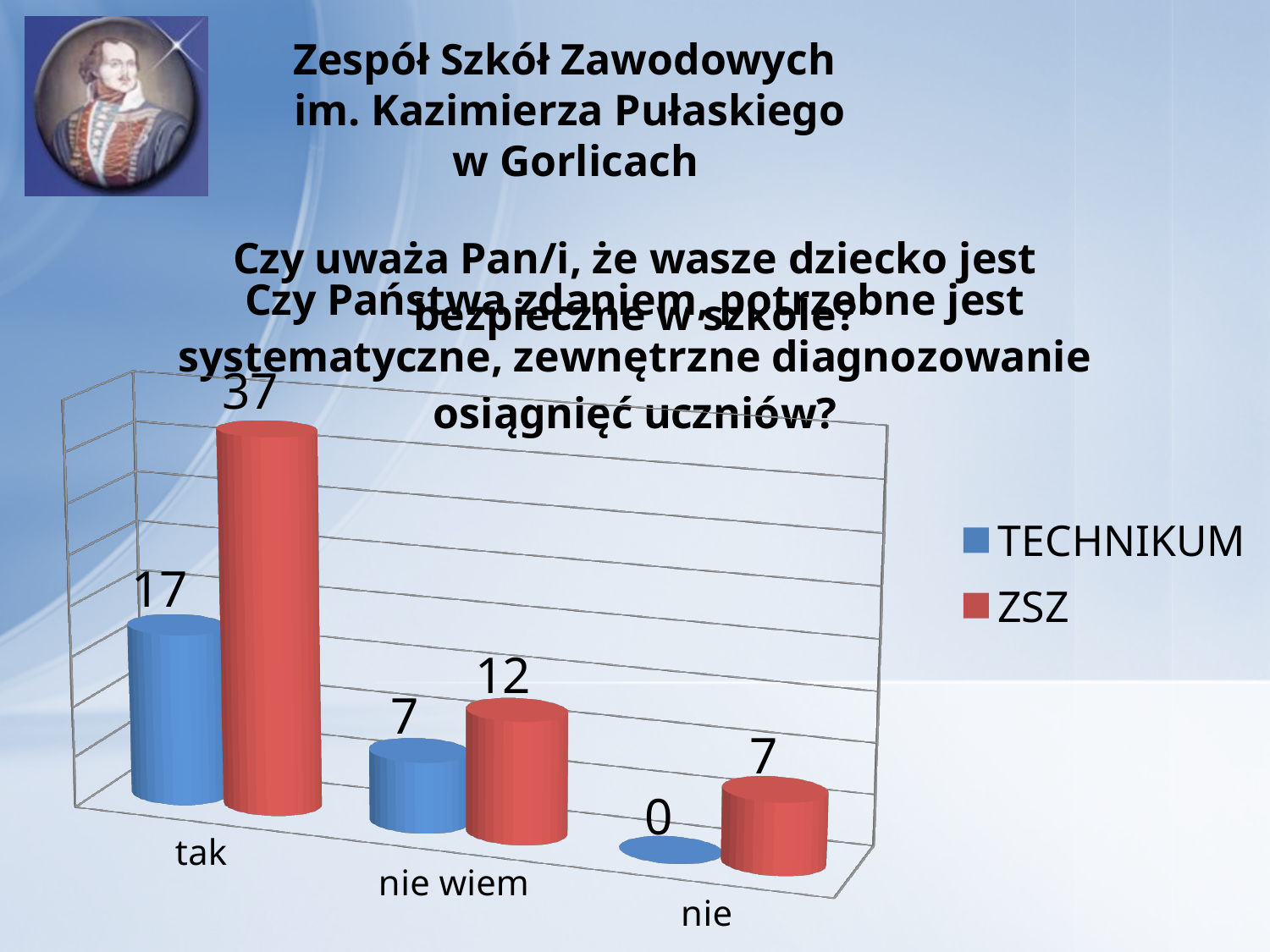
Which category has the highest value for ZSZ? tak What is the difference between the ZSZ and TECHNIKUM values in the "tak" category? 20 What is the value for ZSZ in the "nie" category? 7 What is the value for ZSZ in the "tak" category? 37 In the "nie wiem" category, which series has the larger value, TECHNIKUM or ZSZ? ZSZ What kind of chart is shown on the slide? bar chart What is the value for TECHNIKUM in the "nie wiem" category? 7 How many categories are shown on the x axis? 3 What is the value for TECHNIKUM in the "nie" category? 0 Which category has the lowest value for TECHNIKUM? nie What is the value for TECHNIKUM in the "tak" category? 17 How many series does the legend list? 2